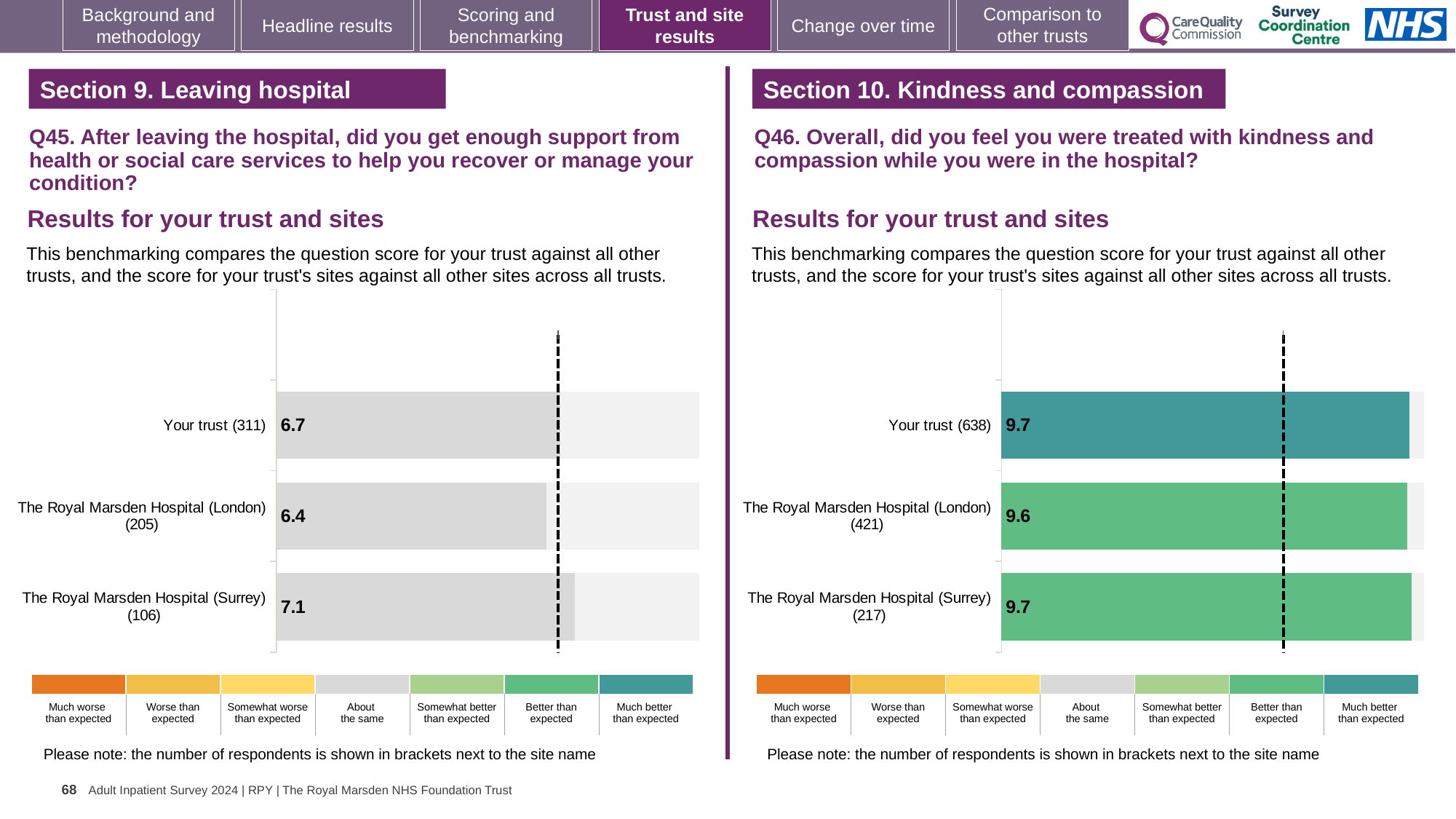
On the Q46 chart (right), what is the difference between the score for Your trust and The Royal Marsden Hospital (London)? 0.1 On the Q45 chart (left), what is the score for The Royal Marsden Hospital (London) (205)? 6.4 On the Q46 chart (right), what is the score for Your trust (638)? 9.7 What type of chart is used on the Q46 chart (right)? Bar chart On the Q45 chart (left), what is the difference between the score for The Royal Marsden Hospital (Surrey) and The Royal Marsden Hospital (London)? 0.7 On the Q45 chart (left), what is the score for Your trust (311)? 6.7 On the Q46 chart (right), which site has the lowest score? The Royal Marsden Hospital (London) (421) On the Q45 chart (left), which site or trust has the lowest score? The Royal Marsden Hospital (London) (205) On the Q46 chart (right), what is the score for The Royal Marsden Hospital (London) (421)? 9.6 On the Q45 chart (left), how many bars are plotted? 3 On the Q45 chart (left), which site or trust has the highest score? The Royal Marsden Hospital (Surrey) (106) On the Q46 chart (right), which benchmark category does the colour of the Your trust bar correspond to in the legend? Much better than expected